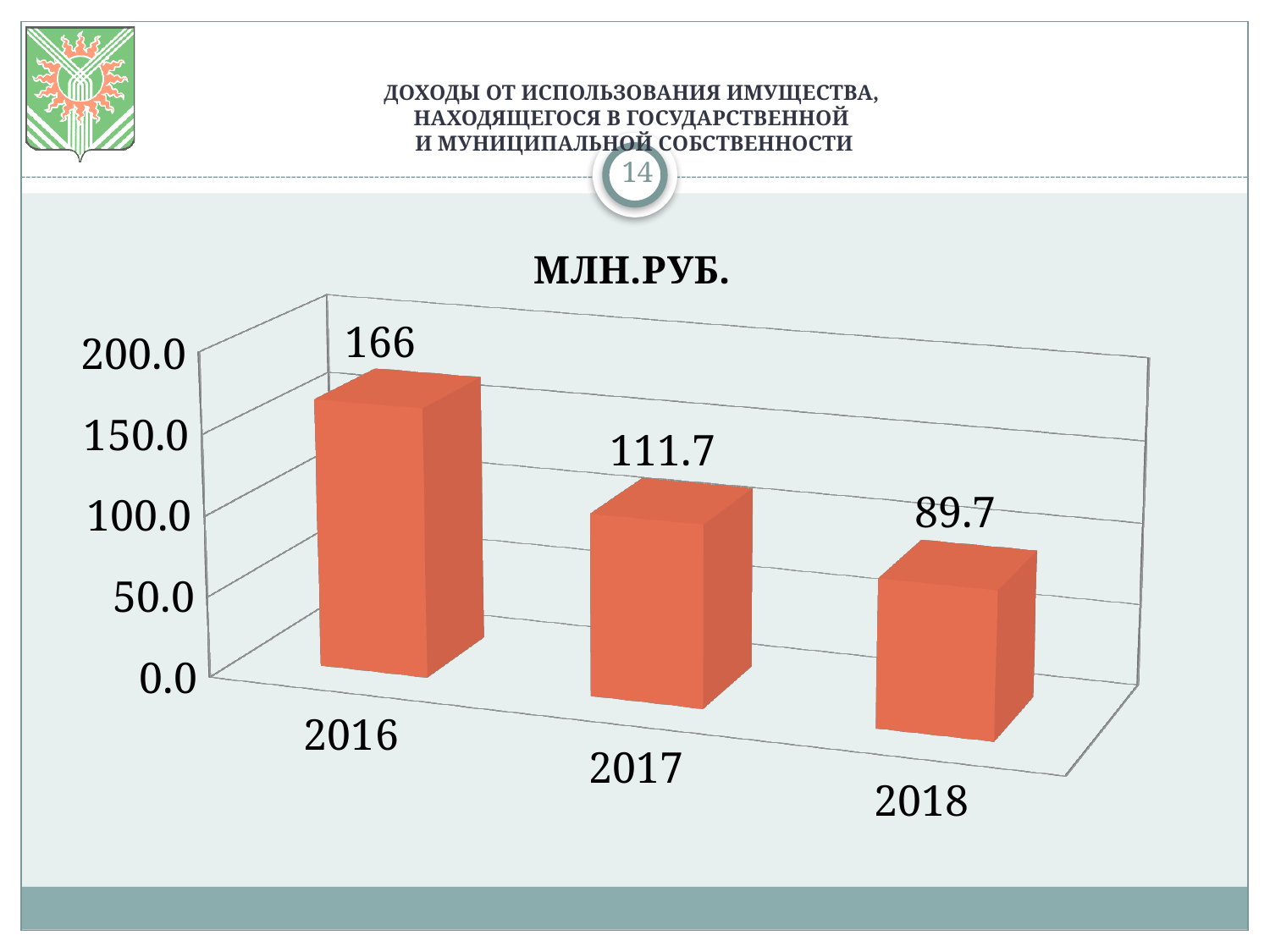
What kind of chart is shown on the slide? bar chart What is the difference between the values for 2017 and 2018? 22 Which year has the lowest value? 2018 Do the values rise or fall from 2016 to 2018? fall Which year has the highest value? 2016 What is the difference between the values for 2016 and 2018? 76.3 How many years are shown on the chart? 3 Is the value for 2016 greater or less than 150.0? greater What is the value for 2018? 89.7 What is the value for 2017? 111.7 Which is larger, the value for 2017 or the value for 2018? 2017 What is the value for 2016? 166